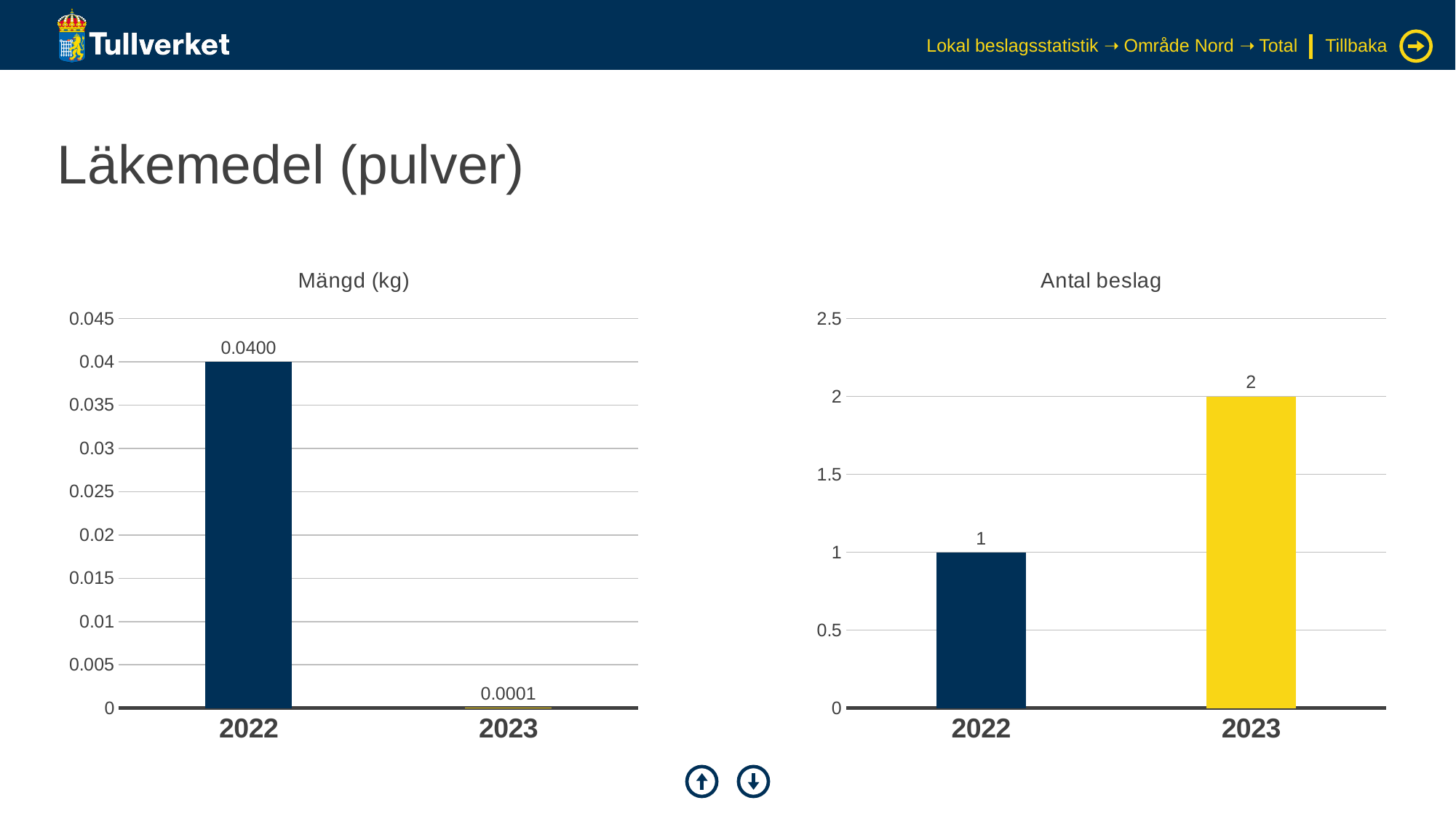
In the 'Mängd (kg)' chart, what is the difference between the values for 2022 and 2023? 0.0399 In the 'Mängd (kg)' chart, do the values rise or fall from 2022 to 2023? fall How many categories are shown on the x axis of the 'Antal beslag' chart? 2 In the 'Antal beslag' chart, which year has the lowest value? 2022 In the 'Antal beslag' chart, what is the difference between the values for 2023 and 2022? 1 What kind of chart is the 'Mängd (kg)' chart? bar chart In the 'Antal beslag' chart, what is the value for 2022? 1 In the 'Antal beslag' chart, what is the value for 2023? 2 In the 'Antal beslag' chart, is the value for 2023 larger or smaller than the value for 2022? larger In the 'Mängd (kg)' chart, what is the value for 2022? 0.0400 In the 'Mängd (kg)' chart, which year has the highest value? 2022 In the 'Mängd (kg)' chart, what is the value for 2023? 0.0001